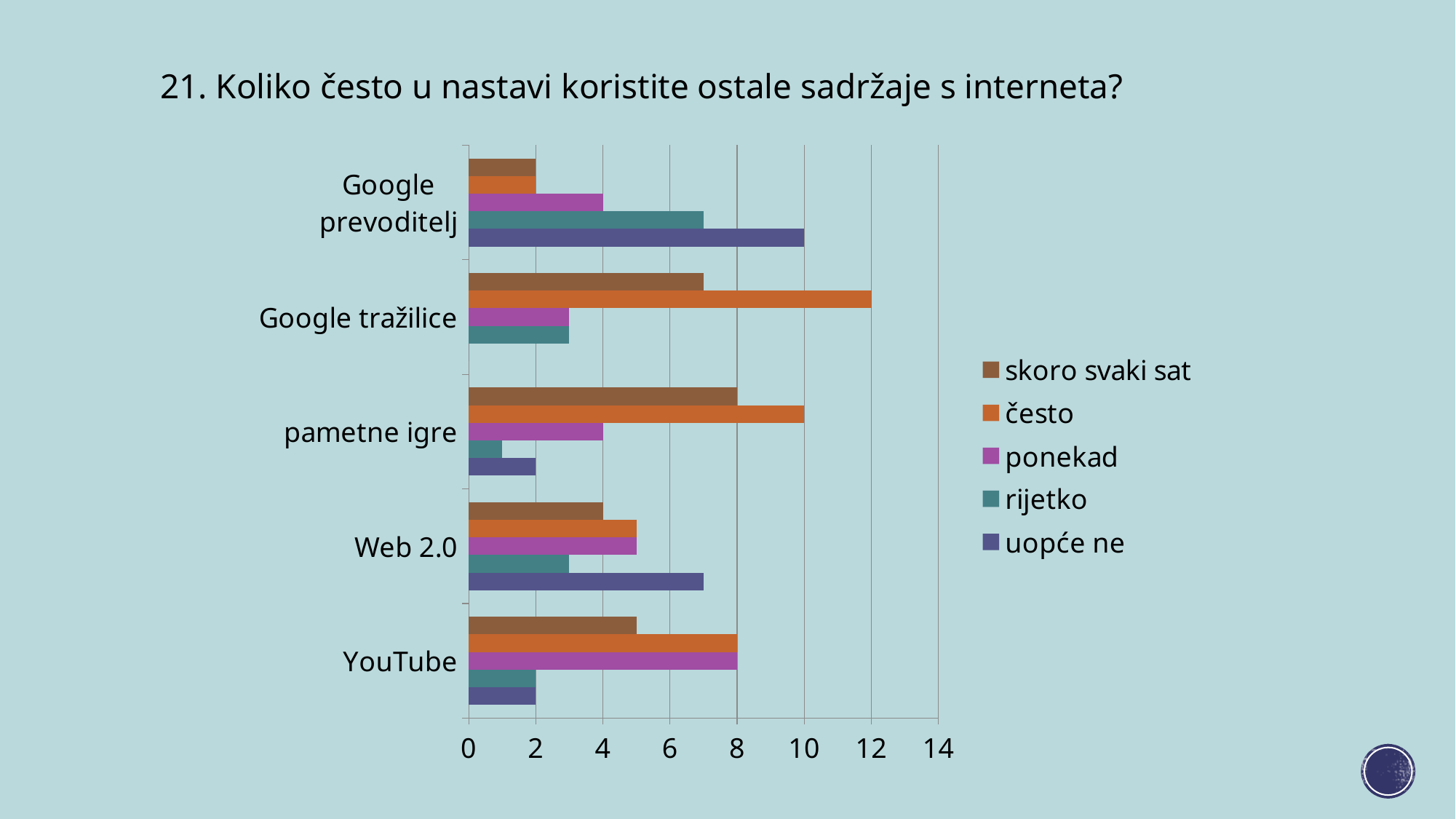
How many categories are shown on the vertical axis? 5 What is the value of "često" for pametne igre? 10 Which is larger for pametne igre: "skoro svaki sat" or "uopće ne"? skoro svaki sat How many series does the legend list? 5 Which category has the highest value for the "često" series? Google tražilice Which category has the lowest value for the "rijetko" series? pametne igre Is the value of "uopće ne" for Web 2.0 greater or less than 6? greater What kind of chart is shown on the slide? bar chart What is the value of "uopće ne" for Google prevoditelj? 10 What is the value of "često" for Google tražilice? 12 What is the value of "ponekad" for YouTube? 8 What is the difference between the "često" value for Google tražilice and the "često" value for YouTube? 4